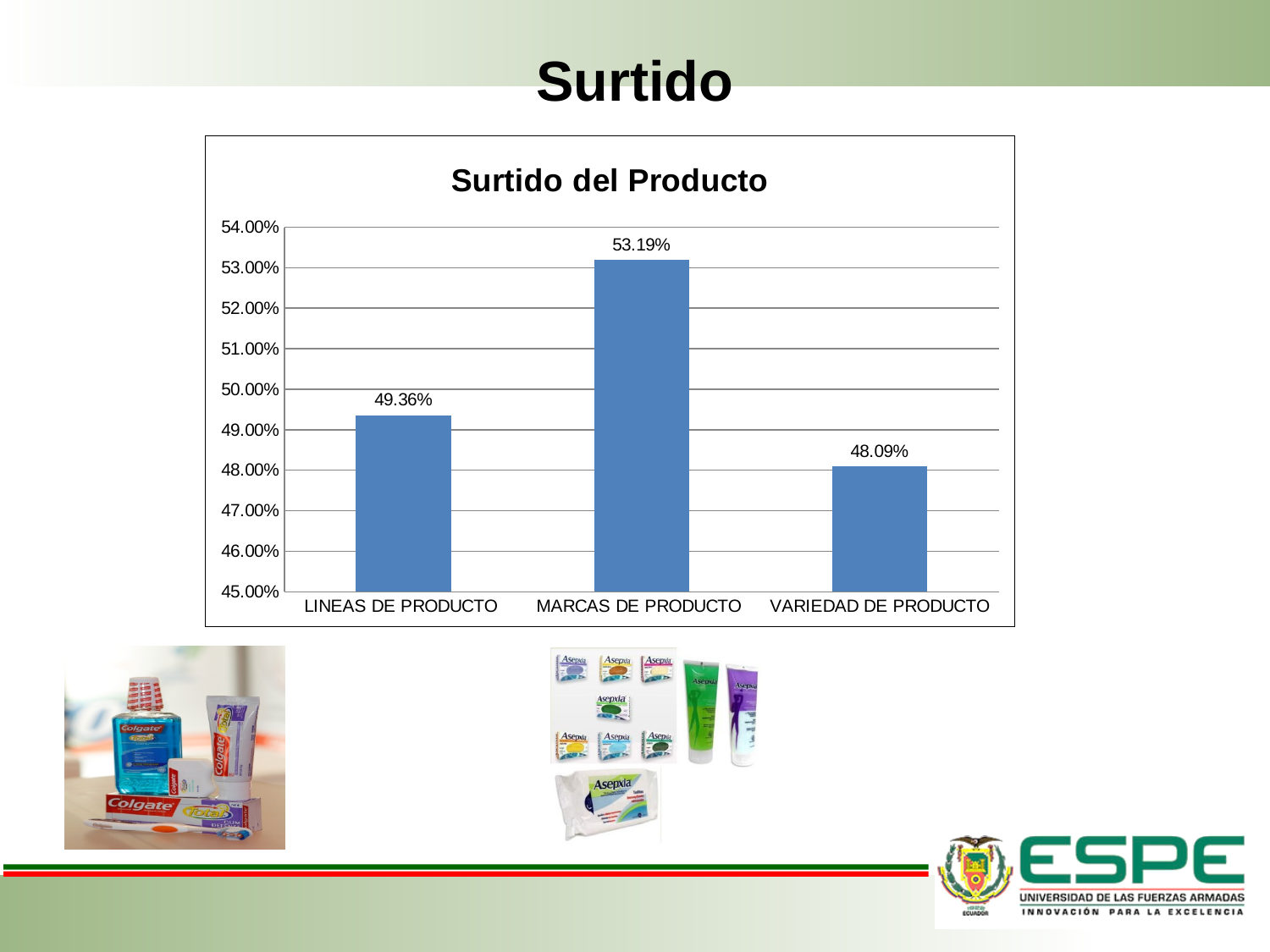
What is the value for LINEAS DE PRODUCTO? 49.36% How many categories are shown on the chart? 3 What is the value for VARIEDAD DE PRODUCTO? 48.09% What is the title of the chart? Surtido del Producto What is the difference between the values for MARCAS DE PRODUCTO and LINEAS DE PRODUCTO? 3.83% What is the value for MARCAS DE PRODUCTO? 53.19% What is the difference between the values for LINEAS DE PRODUCTO and VARIEDAD DE PRODUCTO? 1.27% What kind of chart is shown on the slide? bar chart Which category has the highest value? MARCAS DE PRODUCTO Which category has the lowest value? VARIEDAD DE PRODUCTO Is the value for VARIEDAD DE PRODUCTO greater or less than 50.00%? less Which is larger, the value for LINEAS DE PRODUCTO or VARIEDAD DE PRODUCTO? LINEAS DE PRODUCTO